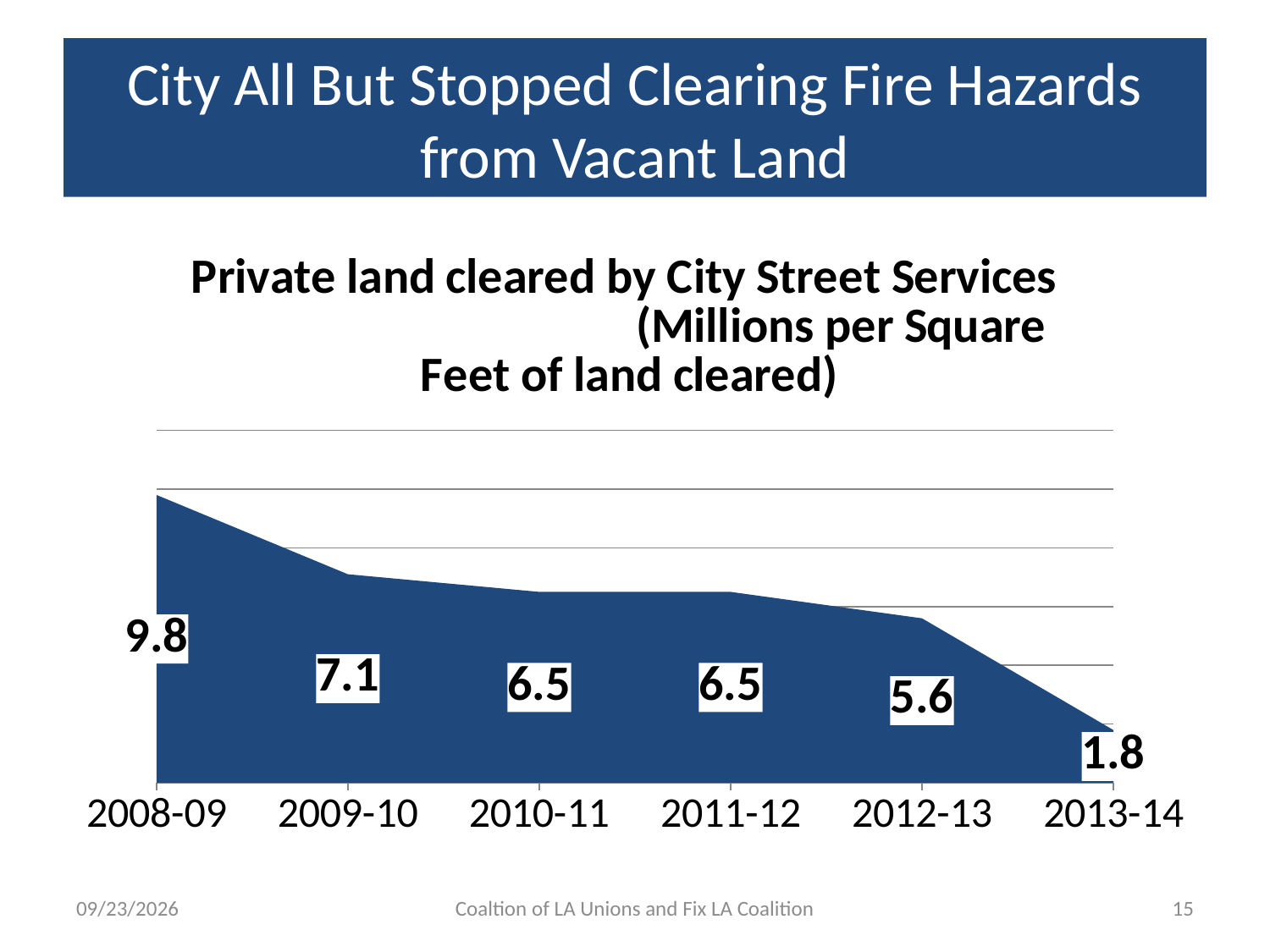
What kind of chart is this? area chart What is the difference between the values for 2008-09 and 2013-14? 8.0 What is the title of the chart? Private land cleared by City Street Services (Millions per Square Feet of land cleared) What is the value for 2012-13? 5.6 How many years are shown on the x axis? 6 Which year has the highest value? 2008-09 Which year has the lowest value? 2013-14 What is the value for 2008-09? 9.8 What is the difference between the values for 2009-10 and 2012-13? 1.5 Do the values rise or fall from 2008-09 to 2013-14? fall Which is larger, the value for 2009-10 or the value for 2012-13? 2009-10 What is the value for 2013-14? 1.8